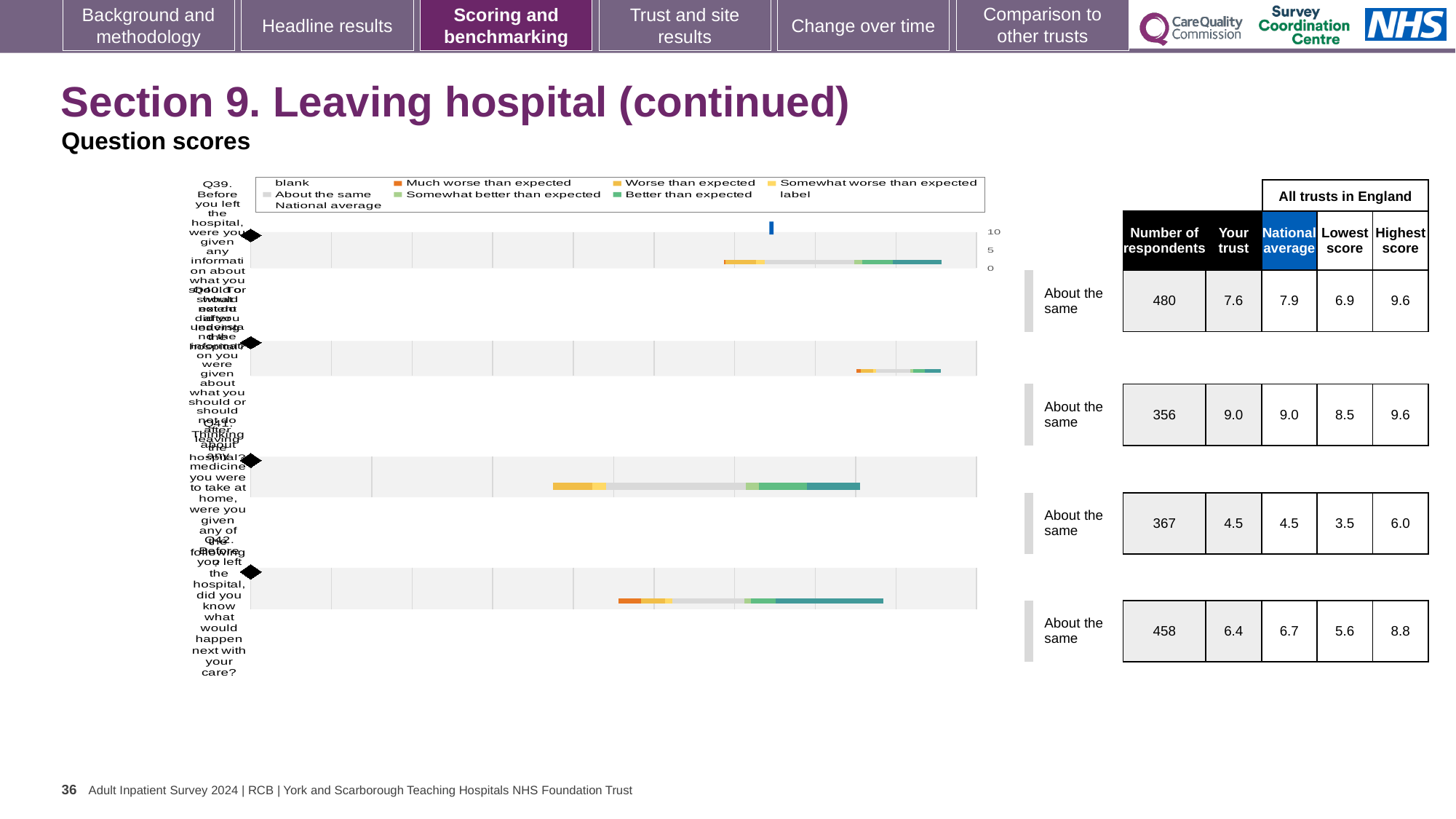
What kind of chart is shown on the slide? bar chart In the table, what is the highest score for the third row? 6.0 Is the 'Your trust' score for the last row (Q42) larger or smaller than its national average? smaller In the table, what is the 'Your trust' score for the first row (Q39)? 7.6 Which row of the table has the highest 'Your trust' score? the second row (9.0) What is the difference between the national average and the 'Your trust' score in the first row (Q39)? 0.3 How many question rows (bars) are plotted in the chart? 4 In the table, what is the national average for the last row (Q42)? 6.7 In the table, what is the number of respondents for the first row (Q39)? 480 What benchmark category is shown next to each of the four rows? About the same What is the subtitle shown under the slide title 'Section 9. Leaving hospital (continued)'? Question scores Which row of the table has the lowest number of respondents? the second row (356)